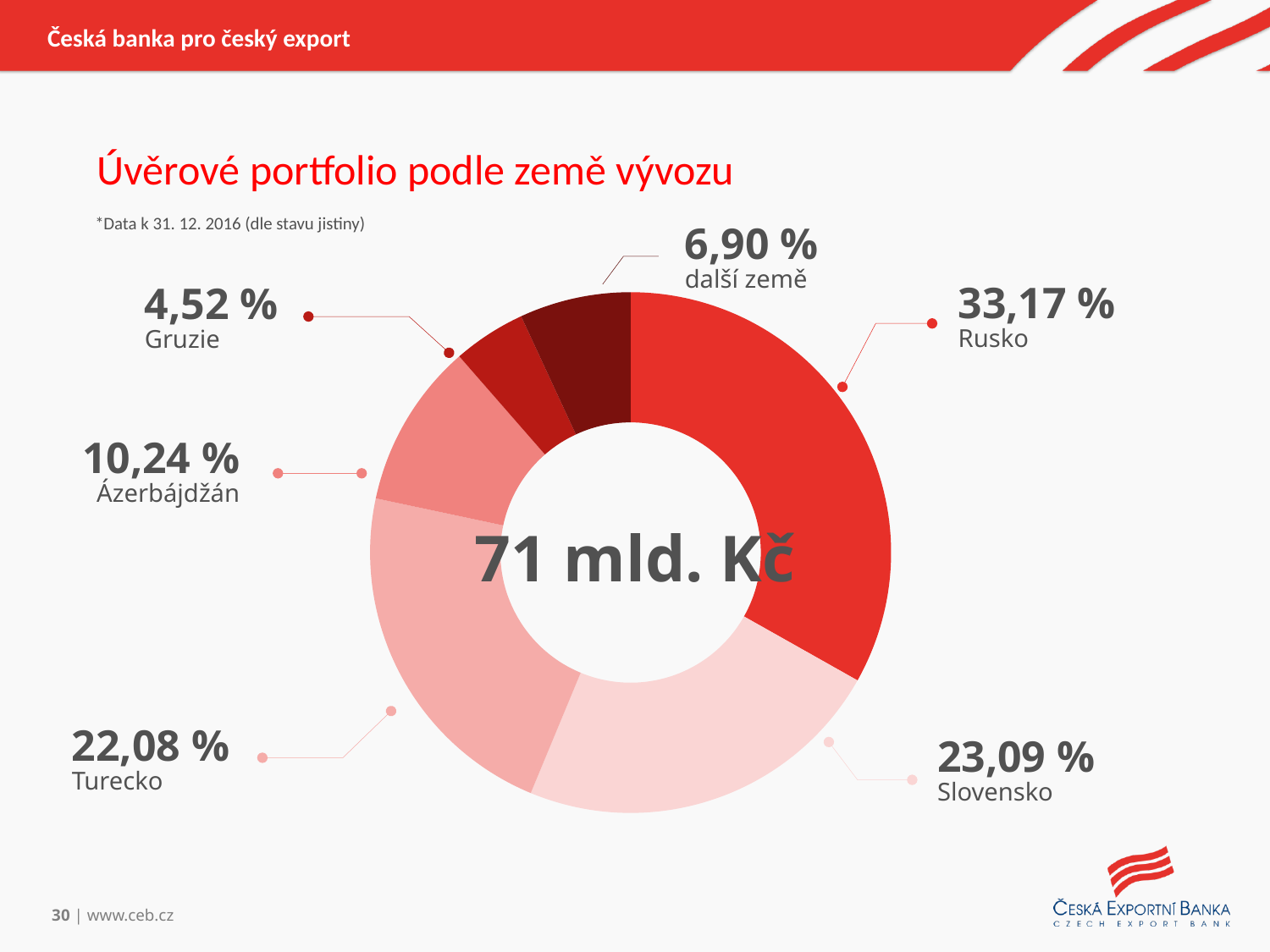
Which named country has the smallest share of the credit portfolio? Gruzie What share is labelled as 'další země'? 6,90 % What total value is shown in the centre of the donut chart? 71 mld. Kč What share of the credit portfolio is attributed to Ázerbájdžán? 10,24 % What is the difference in share between Rusko and Slovensko? 10,08 % What is the title of the chart? Úvěrové portfolio podle země vývozu What share of the credit portfolio is attributed to Slovensko? 23,09 % What share of the credit portfolio is attributed to Gruzie? 4,52 % What share of the credit portfolio is attributed to Rusko? 33,17 % What share of the credit portfolio is attributed to Turecko? 22,08 % Which country has the largest share of the credit portfolio? Rusko What type of chart is shown on the slide? Pie (donut) chart